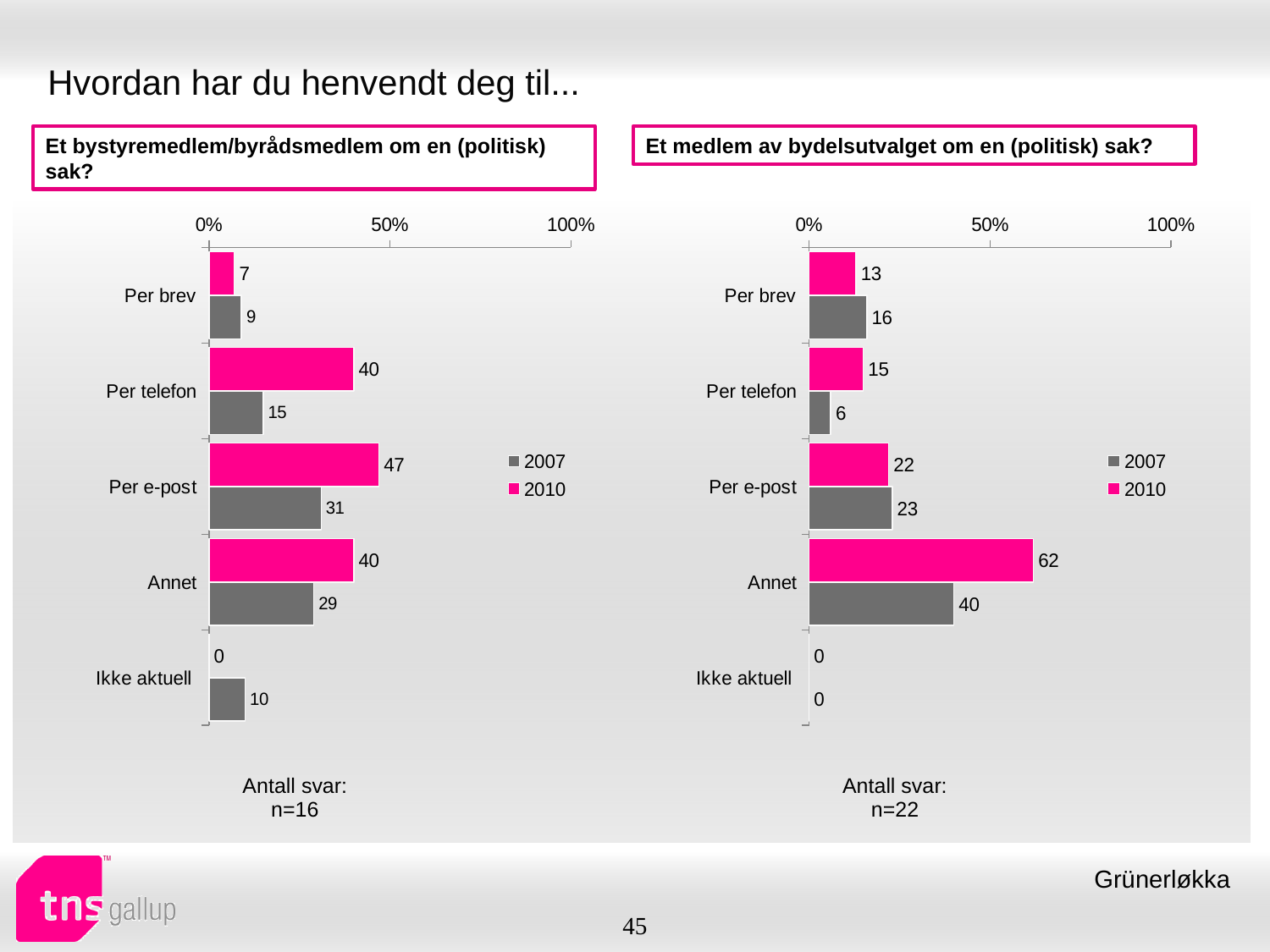
In the left chart (Et bystyremedlem/byrådsmedlem om en (politisk) sak?), which category has the highest 2010 value? Per e-post In the right chart (Et medlem av bydelsutvalget om en (politisk) sak?), what is the value for Per telefon in 2007? 6 How many series does the legend of the right chart (Et medlem av bydelsutvalget om en (politisk) sak?) list? 2 In the left chart (Et bystyremedlem/byrådsmedlem om en (politisk) sak?), what is the difference between the 2010 and 2007 values for Per telefon? 25 How many categories are shown in the left chart (Et bystyremedlem/byrådsmedlem om en (politisk) sak?)? 5 In the left chart (Et bystyremedlem/byrådsmedlem om en (politisk) sak?), what is the value for Per e-post in 2010? 47 In the right chart (Et medlem av bydelsutvalget om en (politisk) sak?), which is larger for Per brev: the 2007 value or the 2010 value? 2007 In the right chart (Et medlem av bydelsutvalget om en (politisk) sak?), what is the value for Annet in 2010? 62 In the right chart (Et medlem av bydelsutvalget om en (politisk) sak?), which category has the highest 2007 value? Annet In the left chart (Et bystyremedlem/byrådsmedlem om en (politisk) sak?), what is the value for Ikke aktuell in 2007? 10 In the right chart (Et medlem av bydelsutvalget om en (politisk) sak?), what is the difference between the 2010 and 2007 values for Annet? 22 What kind of chart is the left chart (Et bystyremedlem/byrådsmedlem om en (politisk) sak?)? Bar chart